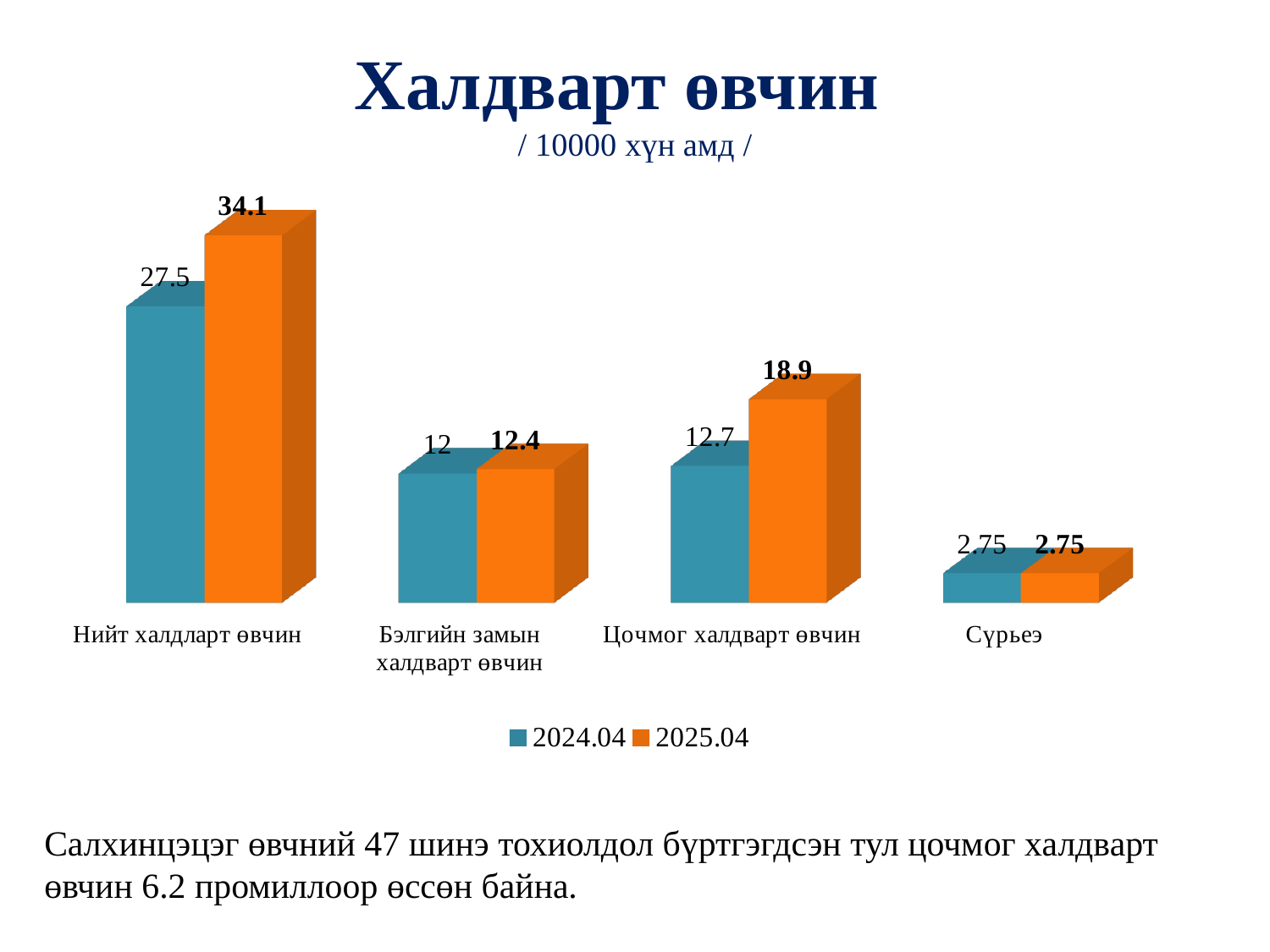
How many categories are shown on the x axis of the chart? 4 How many series does the legend list? 2 What is the value for Бэлгийн замын халдварт өвчин in the 2024.04 series? 12 Which is larger for Цочмог халдварт өвчин: the 2024.04 value or the 2025.04 value? 2025.04 Which category has the lowest value in the 2024.04 series? Сүрьеэ What is the value for Цочмог халдварт өвчин in the 2024.04 series? 12.7 Which category has the highest value in the 2025.04 series? Нийт халдларт өвчин What is the difference between the 2025.04 and 2024.04 values for Нийт халдларт өвчин? 6.6 What is the value for Нийт халдларт өвчин in the 2025.04 series? 34.1 What kind of chart is shown on the slide? Bar chart What is the value for Сүрьеэ in the 2025.04 series? 2.75 What is the difference between the 2025.04 and 2024.04 values for Цочмог халдварт өвчин? 6.2